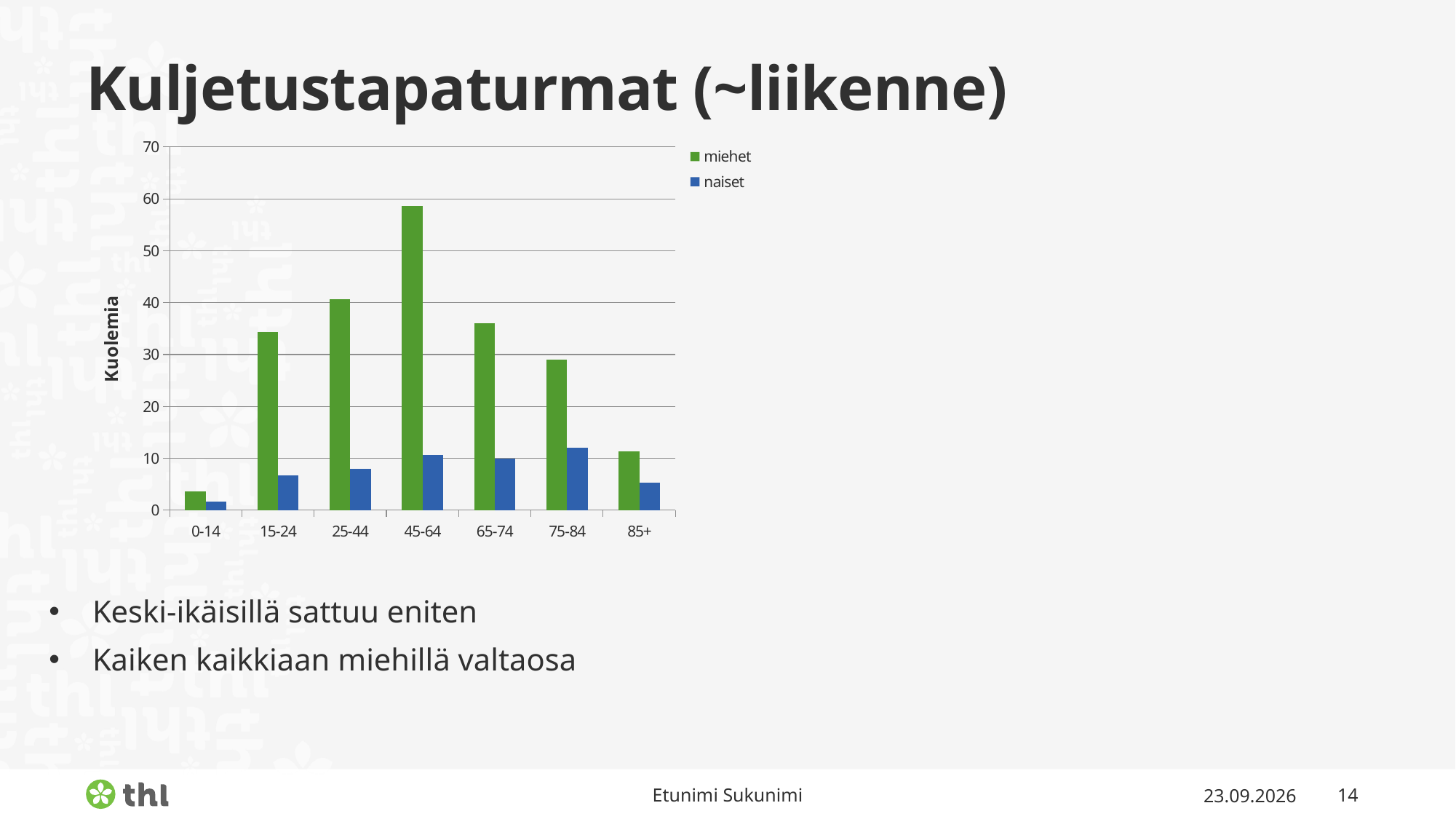
Which age group has the lowest value for miehet? 0-14 Is the value for naiset in the 85+ age group greater or less than 10? less How many age-group categories are shown on the x axis? 7 In the 45-64 age group, which series has the larger value, miehet or naiset? miehet Which age group has the highest value for naiset? 75-84 Which age group has the highest value for miehet? 45-64 Is the value for miehet in the 45-64 age group greater or less than 50? greater What is the title of the vertical axis? Kuolemia Which age group has the lowest value for naiset? 0-14 Is the value for miehet in the 15-24 age group greater or less than 30? greater How many series does the legend list? 2 What kind of chart is shown on the slide? bar chart